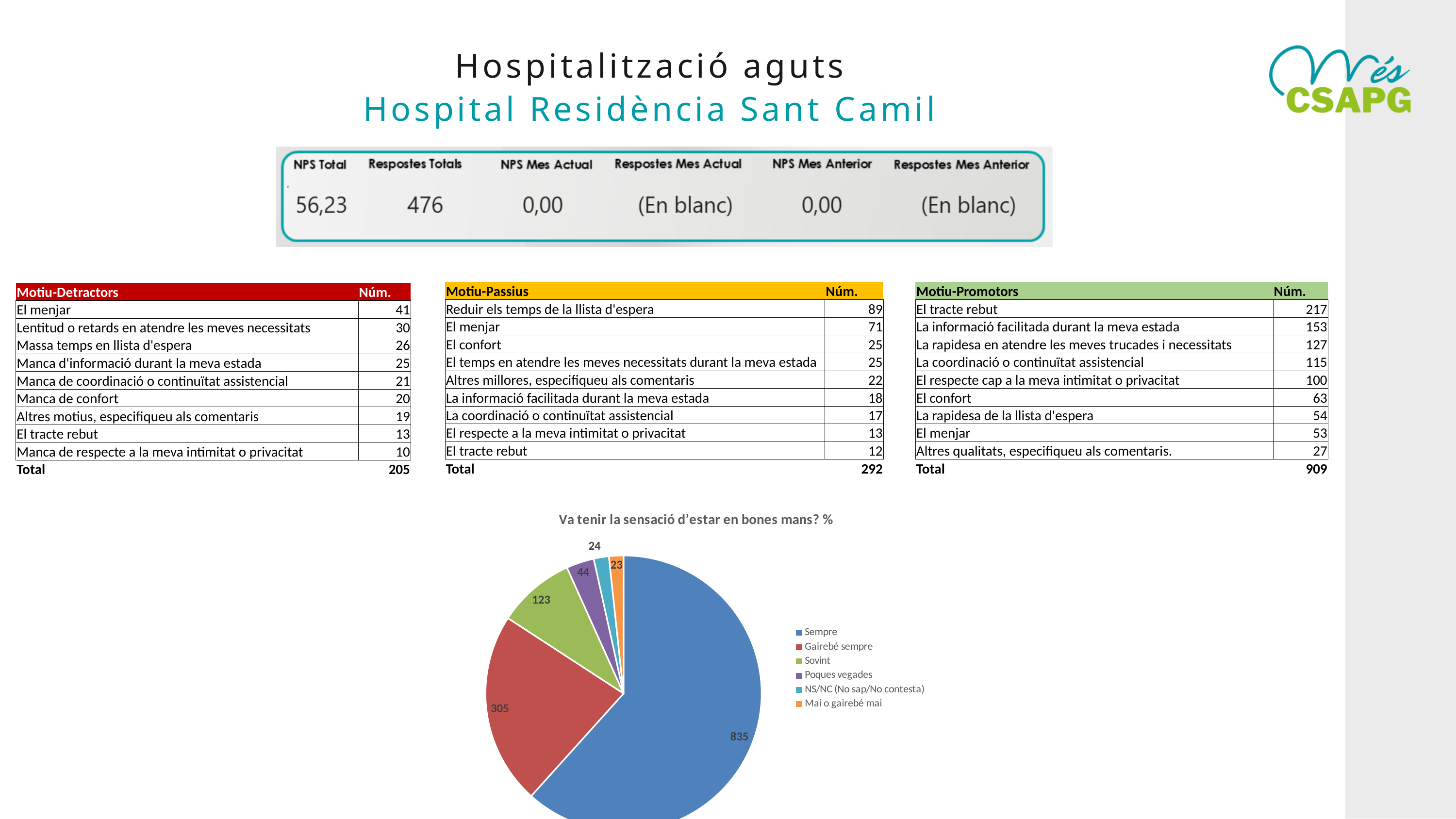
What is the value for 'Poques vegades' in the pie chart? 44 What is the difference between the values for 'Sempre' and 'Gairebé sempre' in the pie chart? 530 What is the title of the pie chart? Va tenir la sensació d'estar en bones mans? % What is the value for 'Sempre' in the pie chart? 835 Which category has the largest slice in the pie chart? Sempre What is the value for 'Sovint' in the pie chart? 123 Which category has the smallest slice in the pie chart? Mai o gairebé mai How many entries does the pie chart's legend list? 6 How many slices does the pie chart have? 6 What type of chart is shown on the slide? pie chart Which is larger in the pie chart, 'Gairebé sempre' or 'Sovint'? Gairebé sempre What is the value for 'Gairebé sempre' in the pie chart? 305